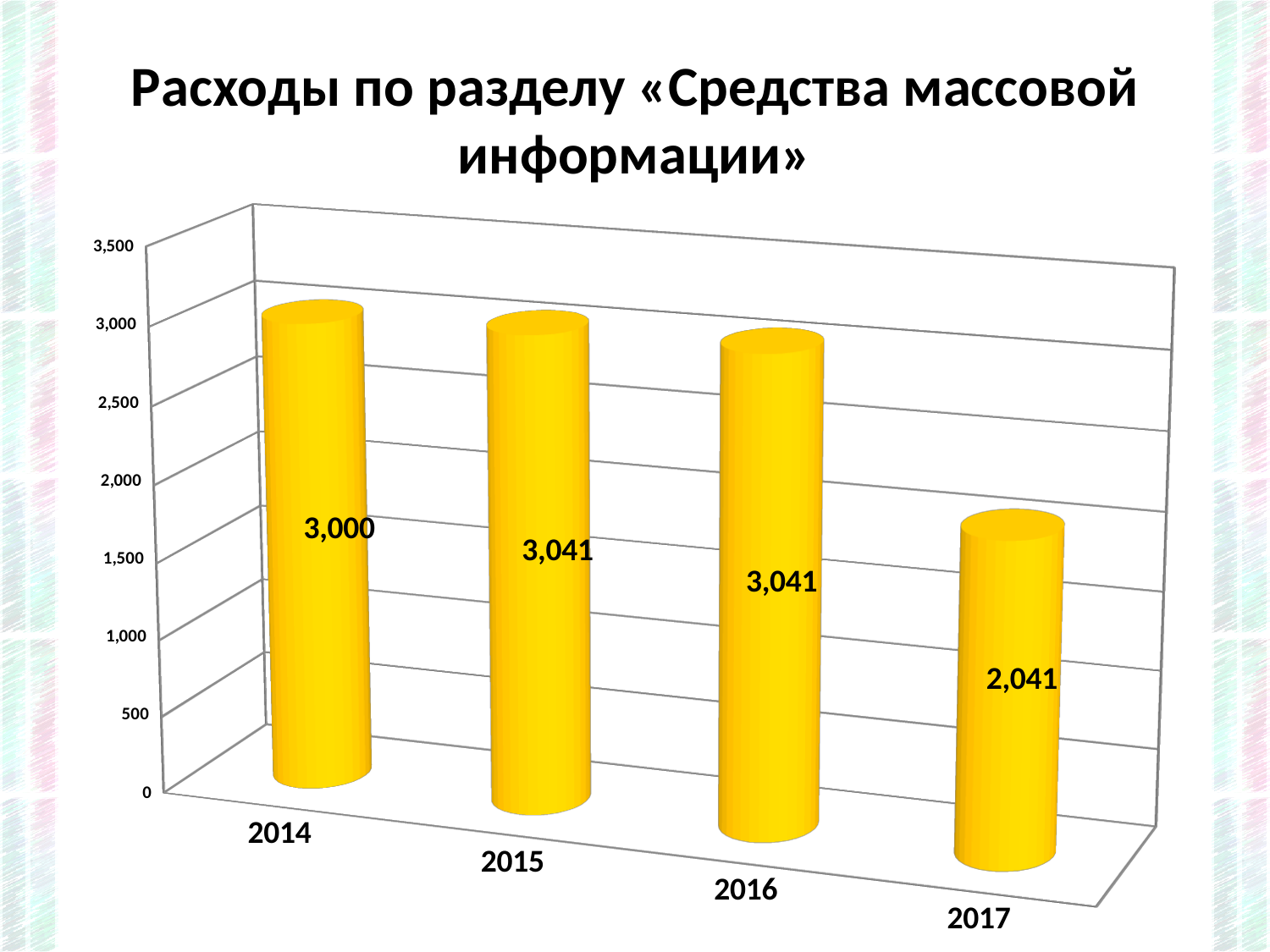
What kind of chart is shown on the slide? bar chart Is the value for 2017 greater or less than 2,500? less What is the value for 2014? 3,000 How many years are shown on the chart? 4 Do the values rise or fall from 2016 to 2017? fall Which year has the lowest value? 2017 What is the difference between the values for 2016 and 2017? 1,000 What is the value for 2017? 2,041 What is the title of the chart? Расходы по разделу «Средства массовой информации» What is the value for 2015? 3,041 What is the difference between the values for 2015 and 2014? 41 Which is larger, the value for 2014 or the value for 2017? 2014